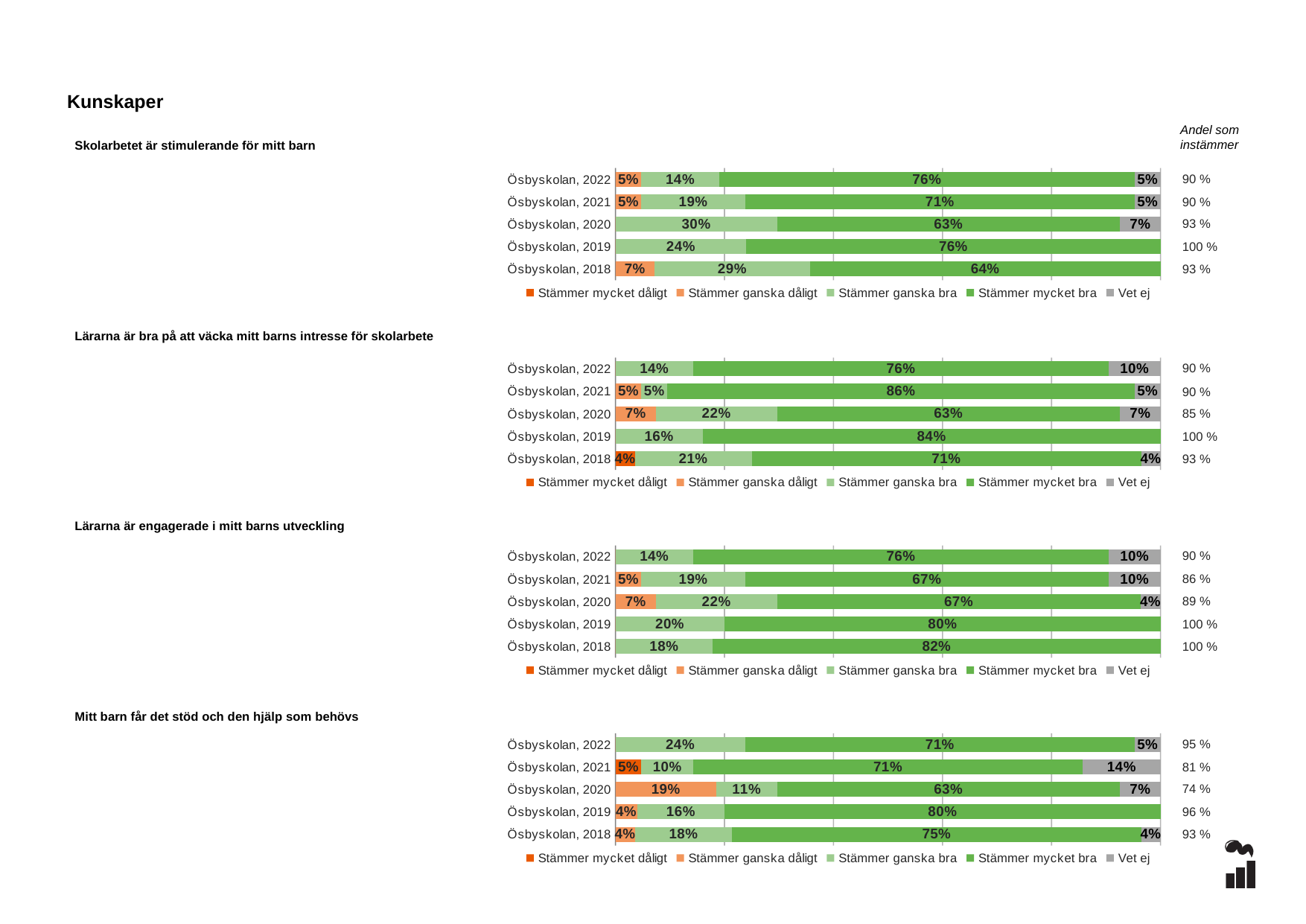
In the chart 'Skolarbetet är stimulerande för mitt barn', what is the 'Stämmer ganska bra' value for Ösbyskolan, 2020? 30% In the chart 'Mitt barn får det stöd och den hjälp som behövs', what is the 'Stämmer ganska dåligt' value for Ösbyskolan, 2020? 19% In the chart 'Skolarbetet är stimulerande för mitt barn', what is the 'Stämmer mycket bra' value for Ösbyskolan, 2022? 76% In the chart 'Skolarbetet är stimulerande för mitt barn', which year has the highest 'Andel som instämmer'? Ösbyskolan, 2019 In the chart 'Lärarna är bra på att väcka mitt barns intresse för skolarbete', what is the 'Stämmer mycket bra' value for Ösbyskolan, 2021? 86% In the chart 'Mitt barn får det stöd och den hjälp som behövs', which year has the lowest 'Andel som instämmer'? Ösbyskolan, 2020 In the chart 'Lärarna är engagerade i mitt barns utveckling', which is larger: the 'Stämmer mycket bra' value for 2019 or for 2018? 2018 In the chart 'Lärarna är bra på att väcka mitt barns intresse för skolarbete', which year has the lowest 'Andel som instämmer'? Ösbyskolan, 2020 In the chart 'Lärarna är bra på att väcka mitt barns intresse för skolarbete', what is the difference between the 'Stämmer mycket bra' values for 2019 and 2018? 13% What kind of chart is used for 'Skolarbetet är stimulerande för mitt barn'? Stacked bar chart How many series does the legend list for the chart 'Mitt barn får det stöd och den hjälp som behövs'? 5 In the chart 'Lärarna är engagerade i mitt barns utveckling', what is the 'Vet ej' value for Ösbyskolan, 2021? 10%